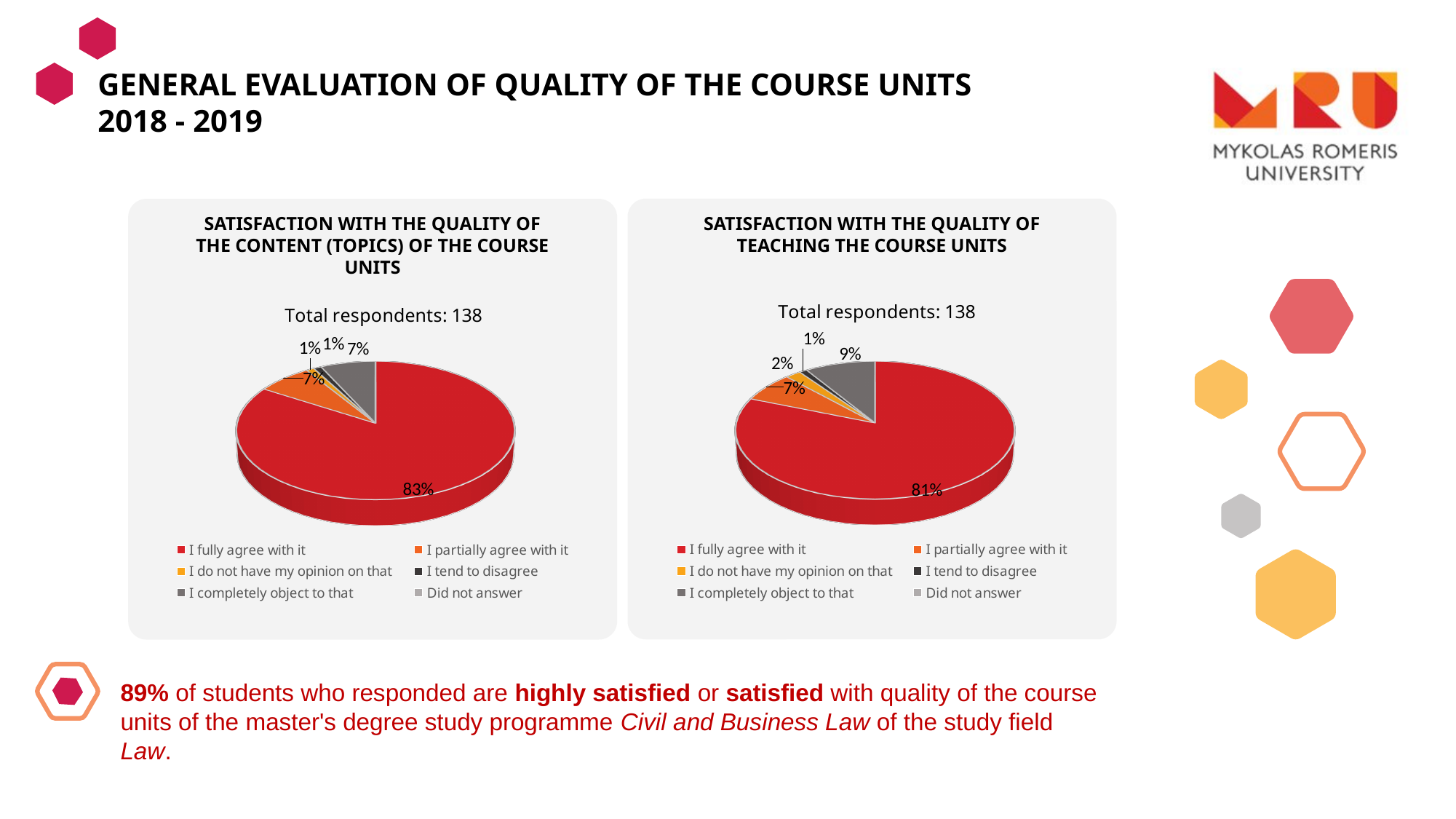
In the right-hand chart (quality of teaching), what share of respondents chose 'I completely object to that'? 9% In the right-hand chart (quality of teaching), which response category has the largest share? I fully agree with it In the chart titled 'Satisfaction with the quality of the content (topics) of the course units', what percentage of respondents chose 'I fully agree with it'? 83% Which chart has a larger 'I completely object to that' share: the content chart or the teaching chart? The teaching chart In the left-hand chart (quality of content), what share of respondents chose 'I partially agree with it'? 7% What type of chart is used for 'Satisfaction with the quality of teaching the course units'? Pie chart In the right-hand chart (quality of teaching), what share of respondents chose 'I do not have my opinion on that'? 2% What is the difference between the 'I fully agree with it' share in the content chart and the 'I fully agree with it' share in the teaching chart? 2% In the chart titled 'Satisfaction with the quality of teaching the course units', what percentage of respondents chose 'I fully agree with it'? 81% In the right-hand chart (quality of teaching), which response category has the smallest share? I tend to disagree How many total respondents are reported for the chart titled 'Satisfaction with the quality of the content (topics) of the course units'? 138 How many response categories does the legend of the left-hand chart (quality of content) list? 6